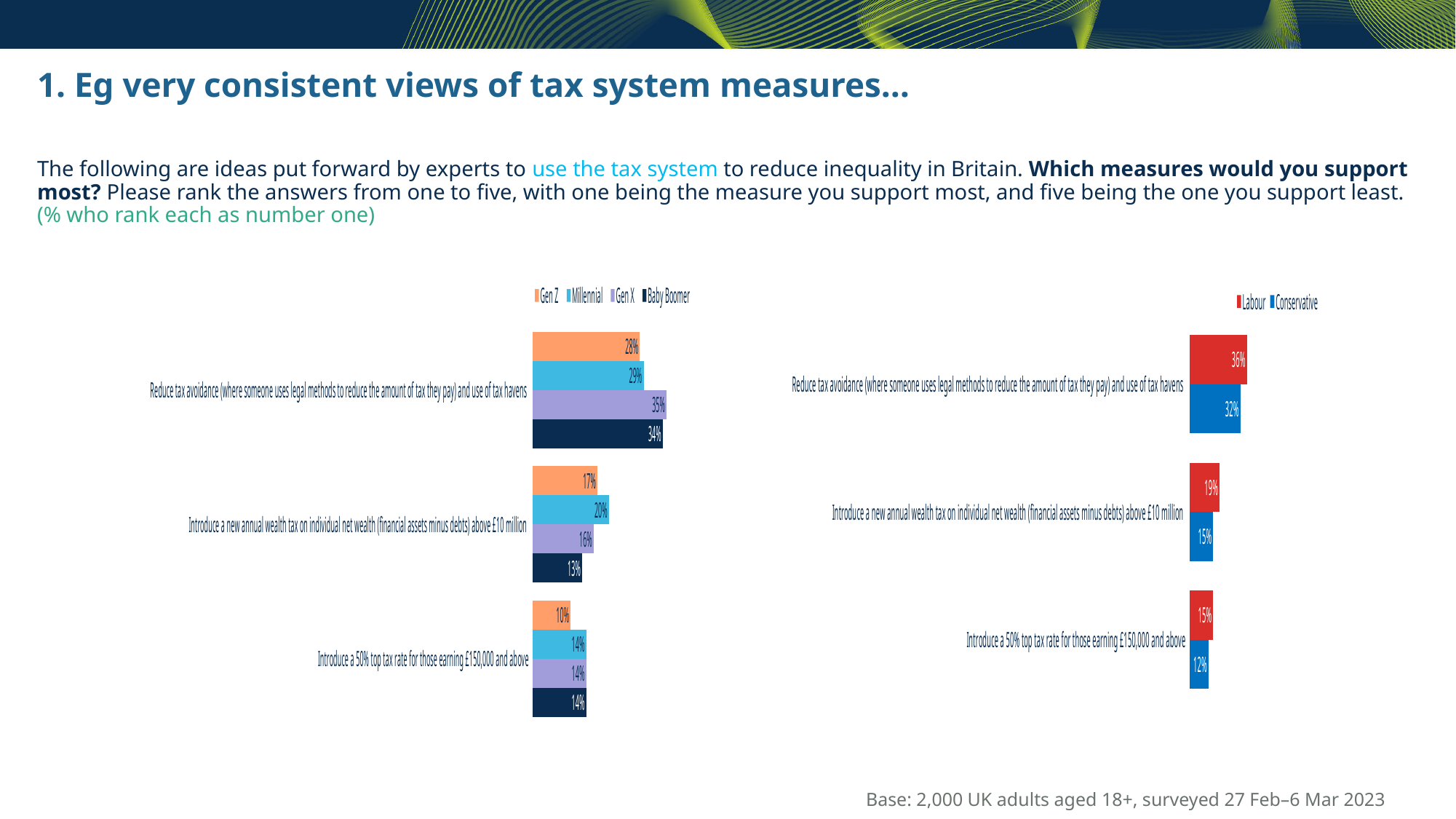
How many series does the legend of the left chart (by generation) list? 4 In the left chart (by generation), what percentage of Gen X rank reducing tax avoidance as number one? 35% What type of chart is the right chart (by party)? Bar chart How many measures (categories) are shown in the right chart (by party)? 3 In the left chart (by generation), what percentage of Baby Boomers rank the new annual wealth tax as number one? 13% In the right chart (by party), what is the difference between the Labour and Conservative values for the new annual wealth tax? 4 percentage points In the right chart (by party), what is the Conservative value for introducing a 50% top tax rate? 12% In the left chart (by generation), what is the Gen Z value for introducing a 50% top tax rate for those earning £150,000 and above? 10% In the left chart (by generation), which generation has the highest value for reducing tax avoidance? Gen X In the right chart (by party), which is larger for reducing tax avoidance: Labour or Conservative? Labour In the left chart (by generation), which generation has the lowest value for the new annual wealth tax? Baby Boomer In the right chart (by party), what percentage of Labour supporters rank reducing tax avoidance as number one? 36%